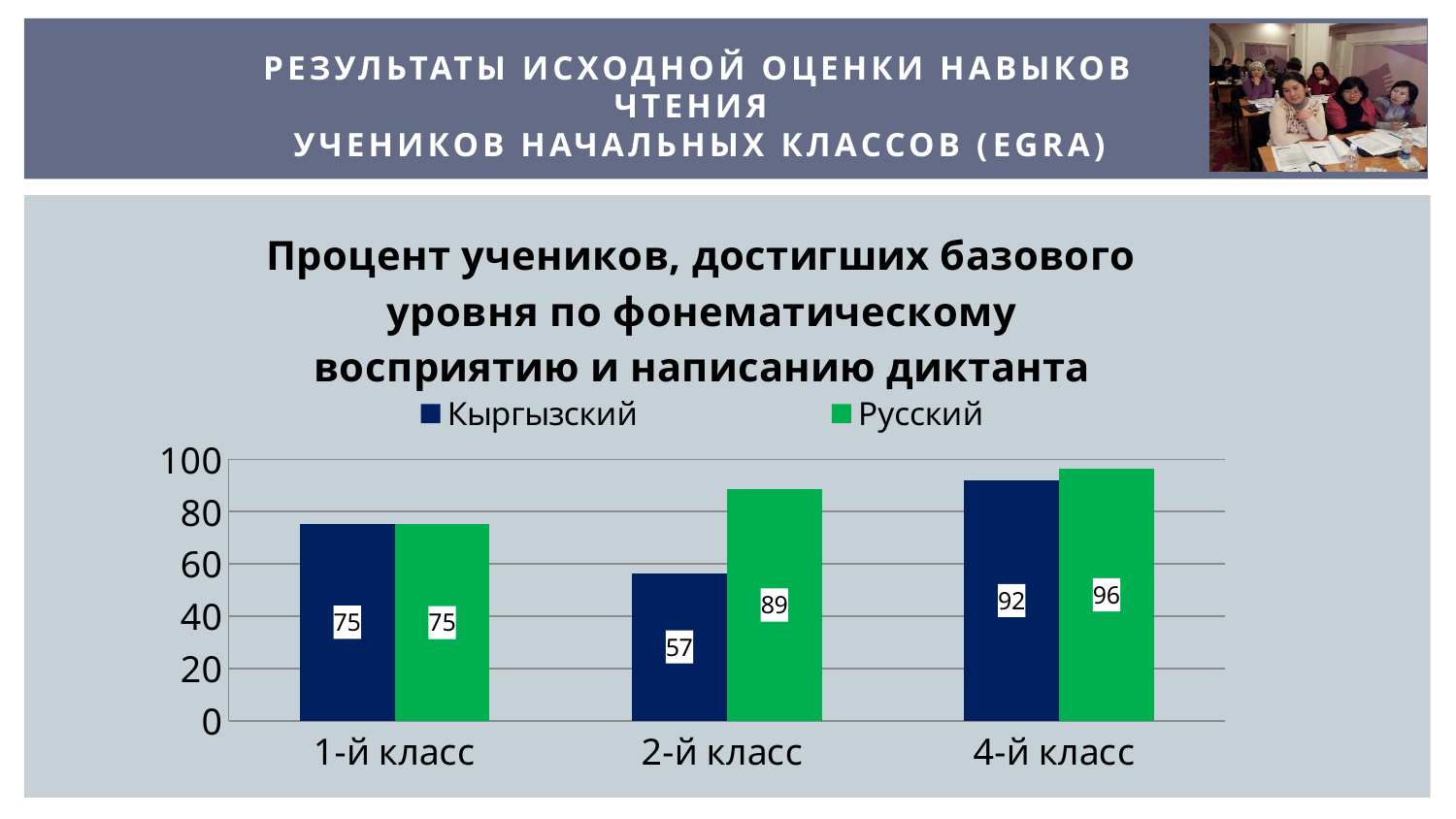
Is the value for Кыргызский in 2-й класс greater or less than 60? less What kind of chart is shown? bar chart What is the value for Русский in 4-й класс? 96 How many series does the legend list? 2 What is the difference between Русский and Кыргызский in 2-й класс? 32 How many classes are shown on the x axis? 3 Which class has the lowest value for Кыргызский? 2-й класс What is the value for Русский in 2-й класс? 89 What is the value for Кыргызский in 2-й класс? 57 Which colour represents Русский in the chart? green Which is larger in 4-й класс, Кыргызский or Русский? Русский Which class has the highest value for Кыргызский? 4-й класс